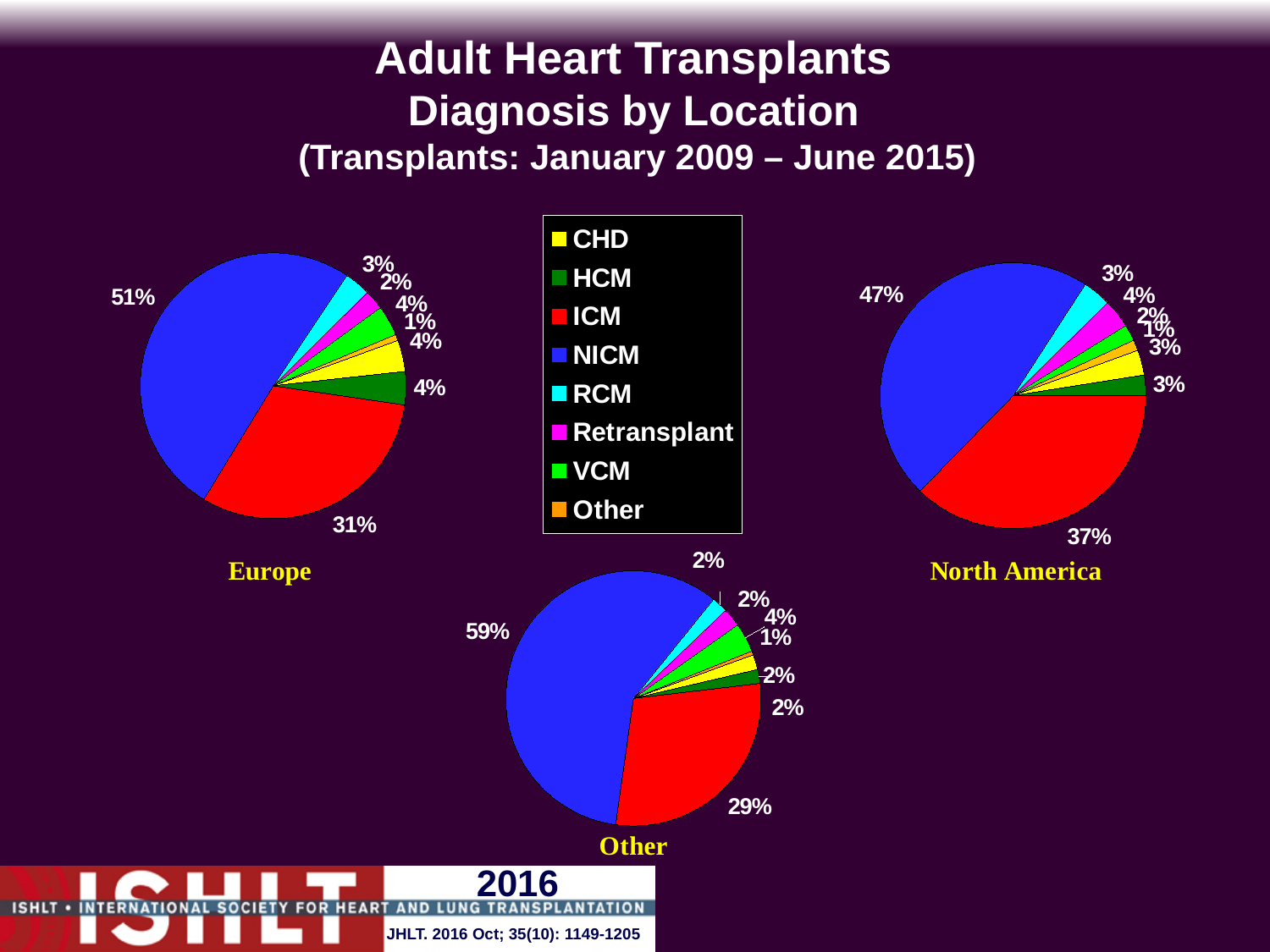
In the Europe pie chart, what share of adult heart transplants had a diagnosis of NICM? 51% Which location has the larger NICM share, Europe or North America? Europe In the North America pie chart, which diagnosis has the largest share? NICM How many diagnosis categories does the legend list? 8 In the Other location pie chart, what share of transplants had a diagnosis of ICM? 29% In the North America pie chart, what share of transplants had a diagnosis of ICM? 37% In the Other location pie chart, what share of transplants had a diagnosis of NICM? 59% Which colour represents ICM in the legend? Red What type of chart is used to show diagnosis by location on this slide? Pie chart In the North America pie chart, what share of transplants had a diagnosis of NICM? 47% In the Europe pie chart, what share of transplants had a diagnosis of ICM? 31% In the Europe pie chart, what is the difference between the NICM share and the ICM share? 20%